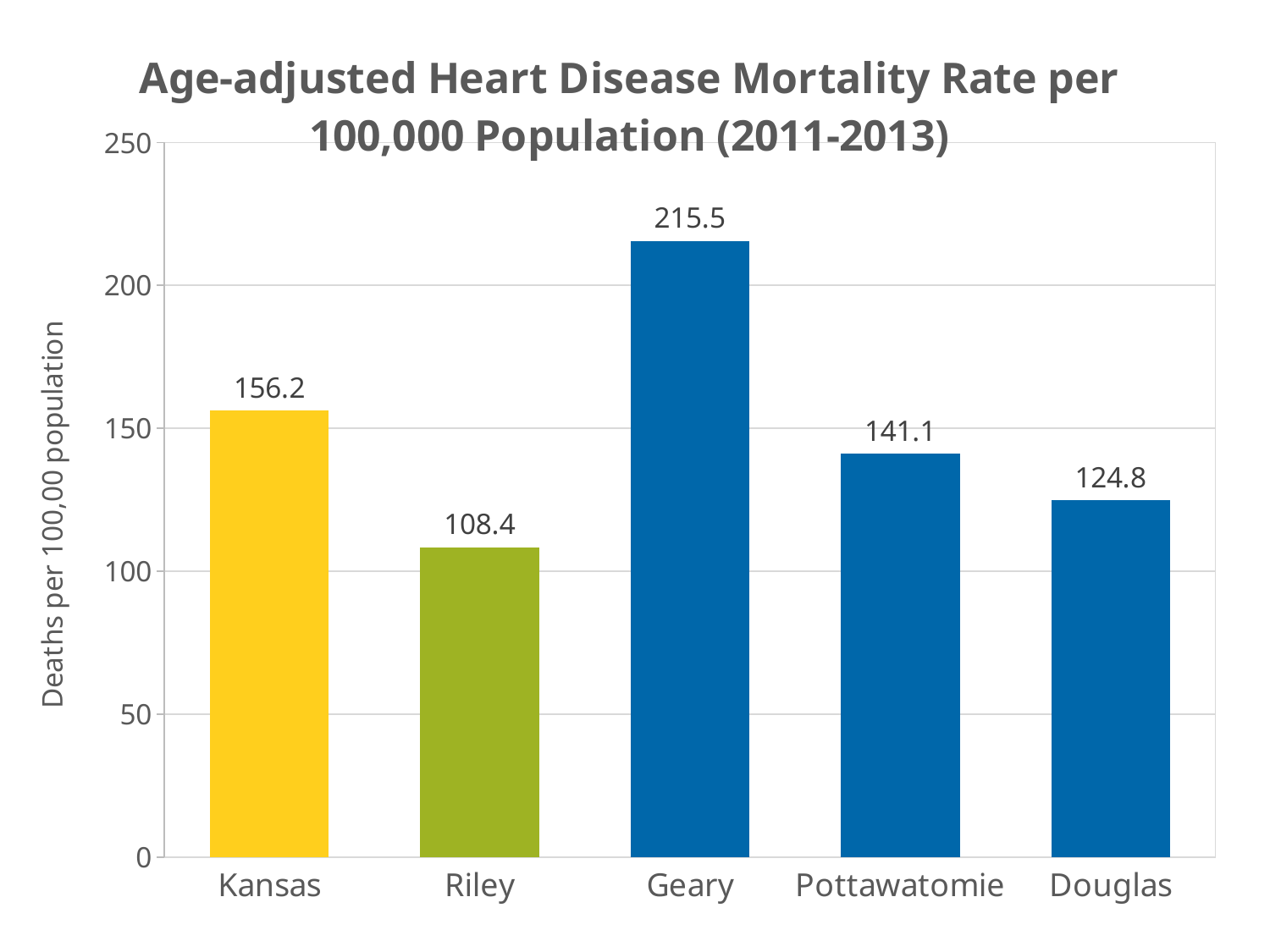
How many categories are shown on the x axis? 5 What is the label of the vertical axis? Deaths per 100,00 population What is the difference between the mortality rates for Geary and Kansas? 59.3 Which category has the lowest heart disease mortality rate? Riley What is the age-adjusted heart disease mortality rate for Kansas? 156.2 Which category has the highest heart disease mortality rate? Geary What is the age-adjusted heart disease mortality rate for Riley? 108.4 Is the value for Geary greater or less than 200? greater What is the difference between the mortality rates for Pottawatomie and Douglas? 16.3 Which has a higher heart disease mortality rate, Kansas or Douglas? Kansas What kind of chart is shown on the slide? Bar chart What is the age-adjusted heart disease mortality rate for Pottawatomie? 141.1